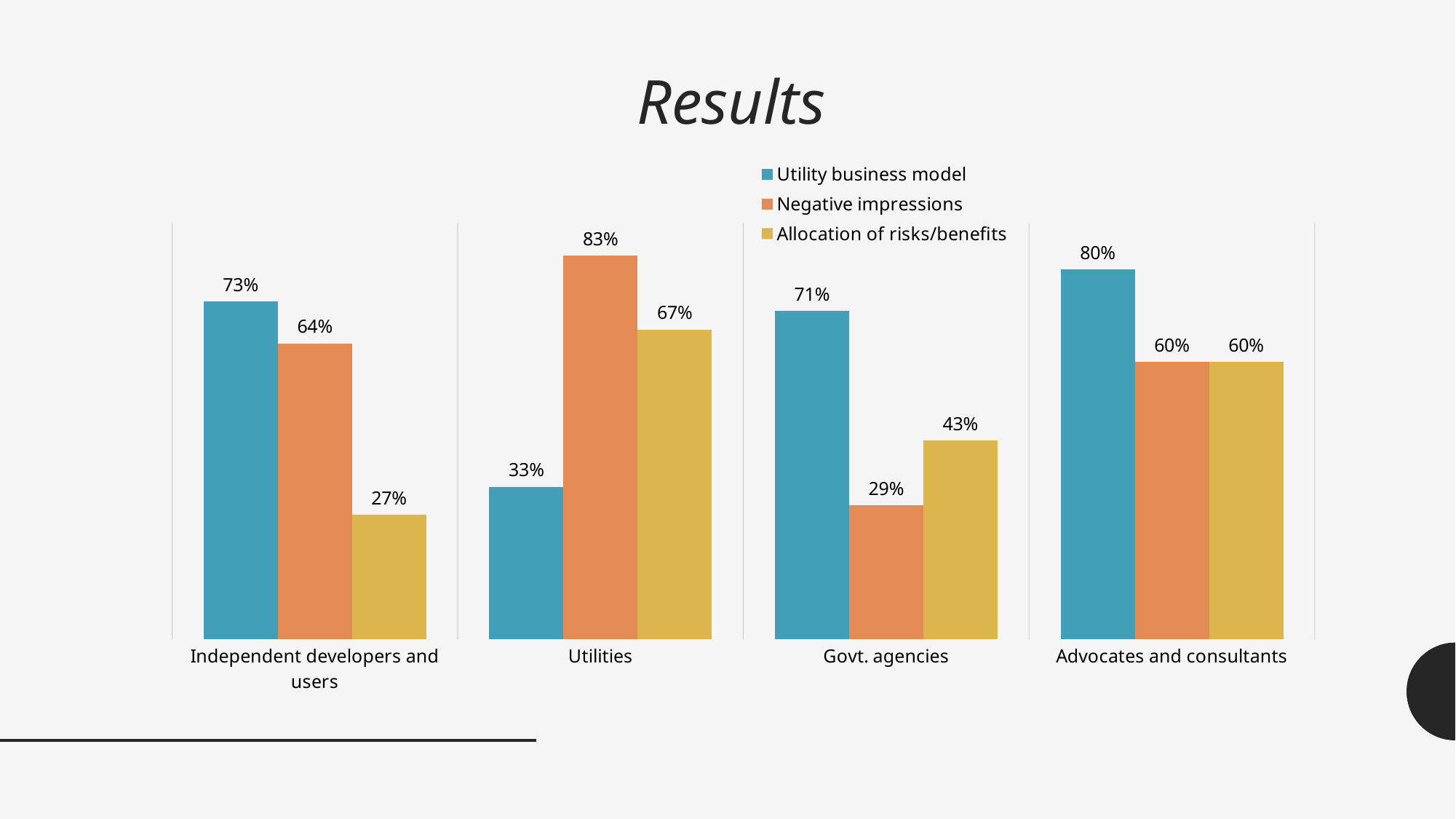
How many series does the legend list? 3 Which category has the lowest value for Negative impressions? Govt. agencies How many categories are shown on the x axis? 4 What is the difference between the Negative impressions value and the Utility business model value for Utilities? 50% What is the value for Allocation of risks/benefits for Govt. agencies? 43% What is the title of the slide? Results What is the value for Negative impressions for Advocates and consultants? 60% What is the value for Negative impressions for Utilities? 83% Which category has the highest value for Utility business model? Advocates and consultants Which is larger for Govt. agencies: Utility business model or Allocation of risks/benefits? Utility business model What kind of chart is shown on the slide? Bar chart What is the value for Utility business model for Independent developers and users? 73%